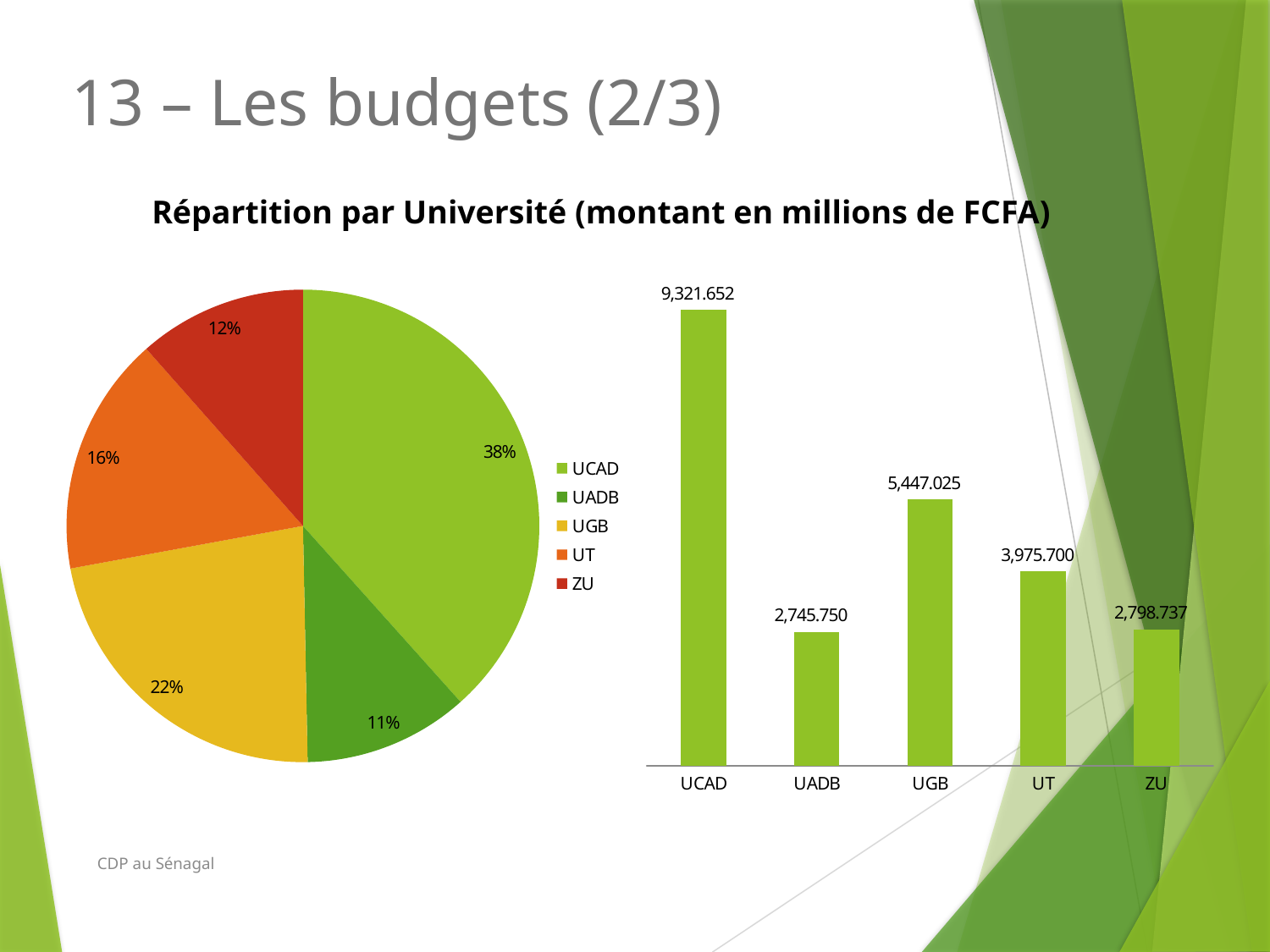
In the pie chart on the left, what share does UGB have? 22% What is the title shown above the two charts? Répartition par Université (montant en millions de FCFA) What kind of chart is the chart on the left of the slide? pie chart In the pie chart on the left, what share does UCAD have? 38% In the bar chart on the right, what is the value for UGB? 5,447.025 In the pie chart on the left, which university has the smallest share? UADB In the bar chart on the right, how many universities are shown on the x axis? 5 In the bar chart on the right, which university has the highest value? UCAD In the pie chart on the left, how many entries does the legend list? 5 In the bar chart on the right, what is the value for ZU? 2,798.737 In the bar chart on the right, which is larger, the value for UGB or the value for UT? UGB In the bar chart on the right, what is the difference between the values for UCAD and UADB? 6,575.902